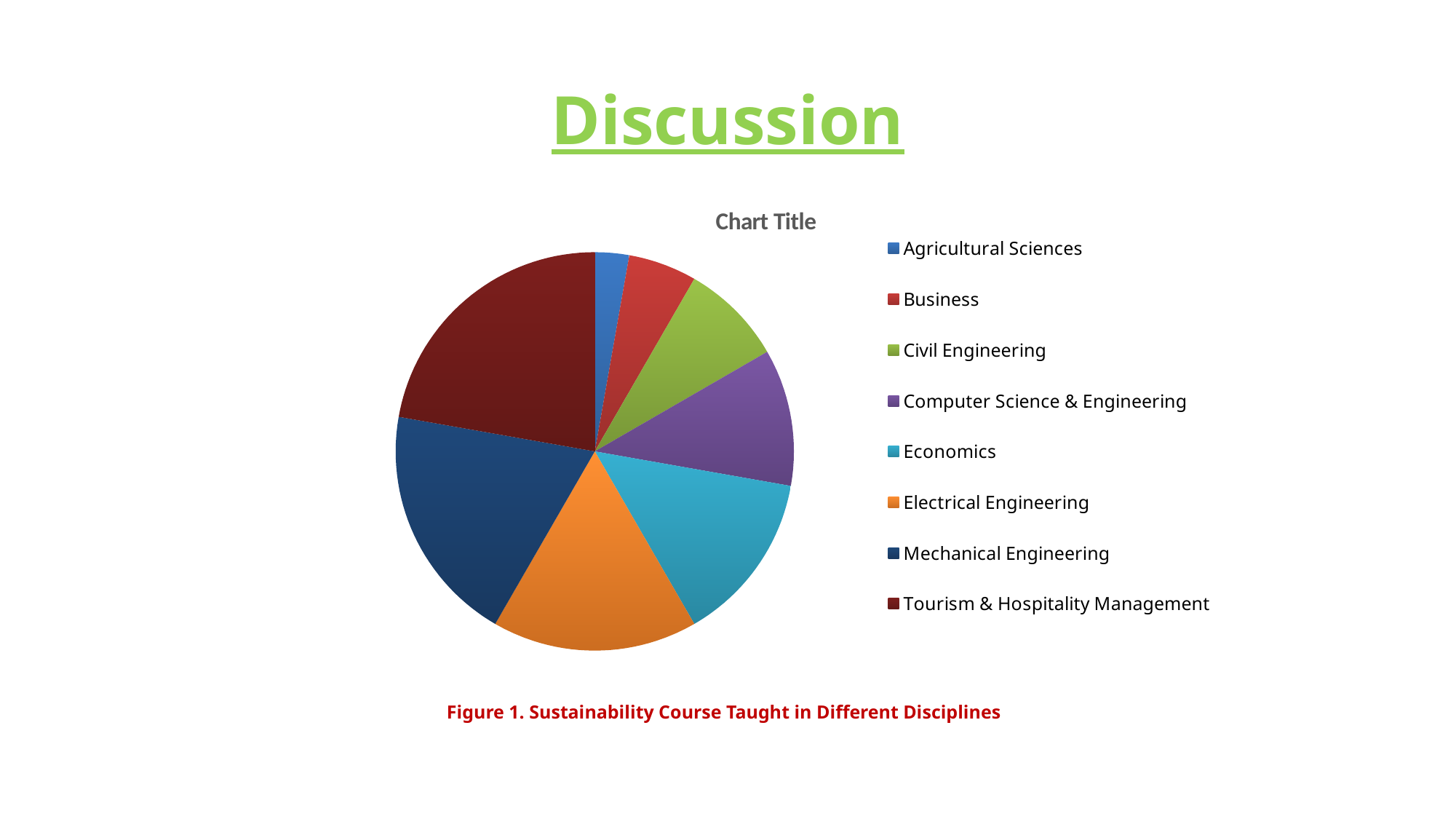
Which slice is larger, Economics or Business? Economics Which discipline has the largest slice of the pie chart? Tourism & Hospitality Management How many categories does the pie chart show? 8 What is the figure caption below the pie chart? Figure 1. Sustainability Course Taught in Different Disciplines Which discipline has the smallest slice of the pie chart? Agricultural Sciences What is the title printed above the pie chart? Chart Title Which slice is larger, Agricultural Sciences or Electrical Engineering? Electrical Engineering What kind of chart is shown on the slide? Pie chart Which slice is larger, Computer Science & Engineering or Agricultural Sciences? Computer Science & Engineering